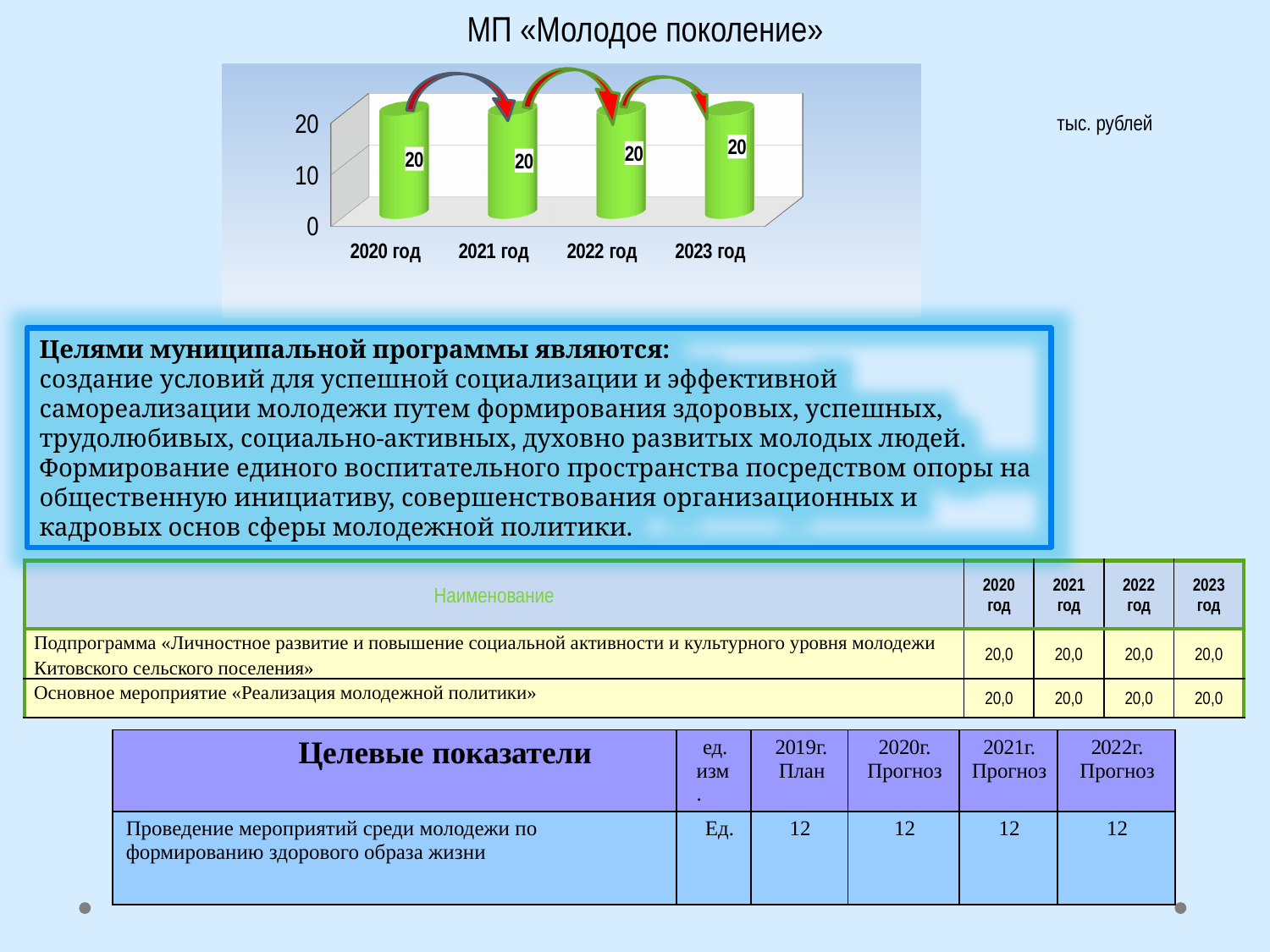
What is the highest tick value shown on the vertical axis of the chart? 20 What kind of chart is shown on the slide? Bar chart What is the value for 2020 год in the chart? 20 Do the values rise, fall, or stay the same from 2020 год to 2023 год? Stay the same What is the value for 2022 год in the chart? 20 What is the title shown above the chart? МП «Молодое поколение» What is the value for 2023 год in the chart? 20 Is the value for 2022 год greater or less than 10? greater How many categories (years) are shown on the x axis of the chart? 4 What is the difference between the values for 2023 год and 2020 год? 0 What is the value for 2021 год in the chart? 20 What unit of measurement is indicated next to the chart? тыс. рублей